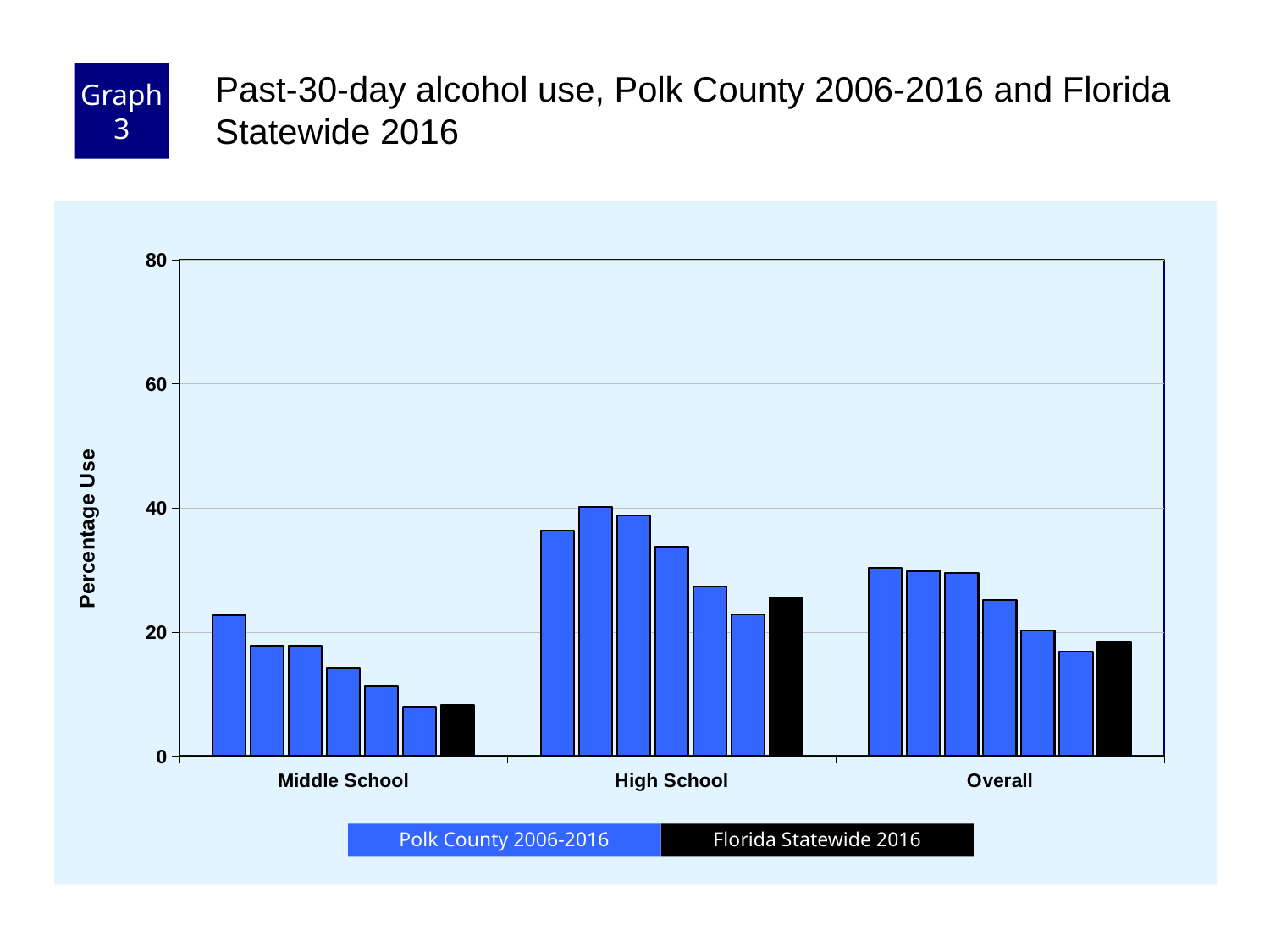
Which category has the lowest Florida Statewide 2016 bar? Middle School Which category has the highest Florida Statewide 2016 bar? High School Is the first (leftmost) Polk County bar for Overall greater or less than 20? greater Is the Florida Statewide 2016 value for High School greater or less than 20? greater How many categories are shown on the x axis? 3 Is the Florida Statewide 2016 value for Middle School greater or less than 20? less How many series does the legend list? 2 Which is larger: the Florida Statewide 2016 bar for Overall or the Florida Statewide 2016 bar for High School? High School What is the label on the y axis? Percentage Use Do the Polk County 2006-2016 bars for Middle School rise or fall from left to right? fall What kind of chart is shown on the slide? bar chart